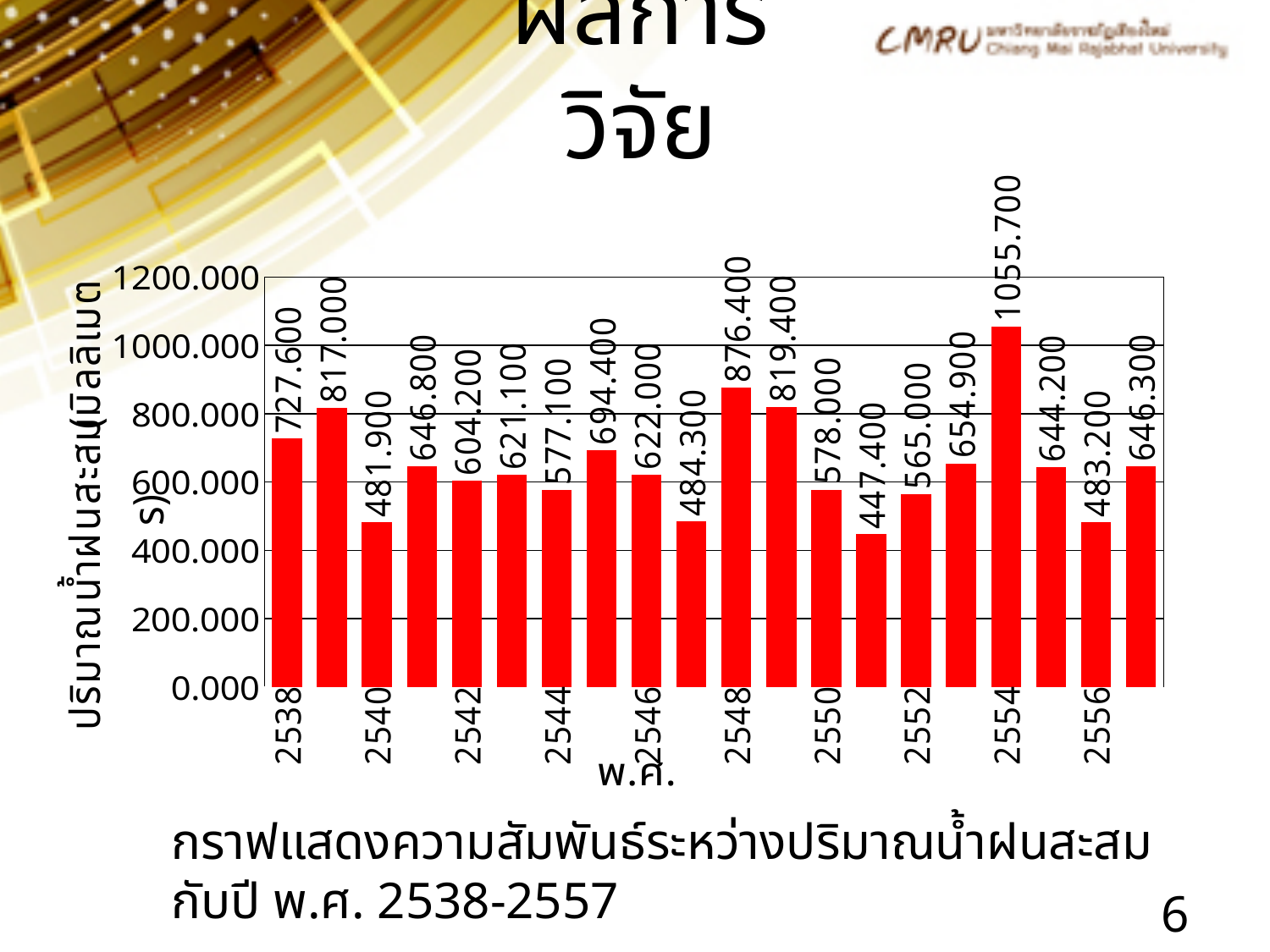
Which year has the highest cumulative rainfall? 2554 What type of chart is shown on the slide? bar chart What is the cumulative rainfall value for the year 2540? 481.900 Which year has a larger cumulative rainfall value, 2542 or 2546? 2546 Is the cumulative rainfall value for 2550 greater or less than 600.000? less How many bars are plotted in the chart? 20 What is the difference between the cumulative rainfall values for 2554 and 2538? 328.100 What colour are the bars in the chart? red What is the cumulative rainfall value for the year 2548? 876.400 What is the lowest cumulative rainfall value shown in the chart? 447.400 What is the cumulative rainfall value for the year 2538? 727.600 What is the cumulative rainfall value for the year 2554? 1055.700